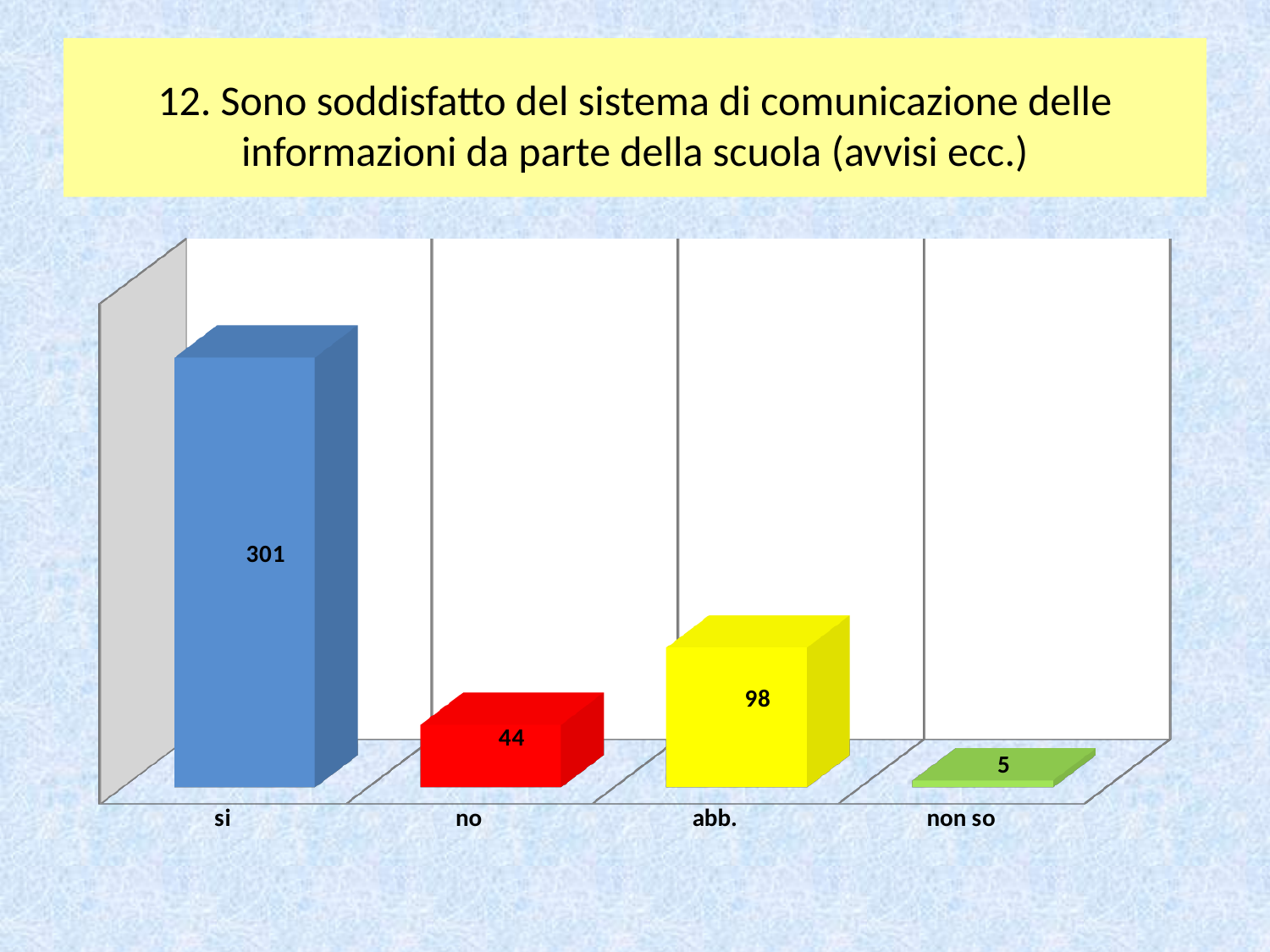
What is the difference between the values for "si" and "abb."? 203 How many categories are shown on the x axis? 4 What kind of chart is shown on the slide? bar chart What is the value for "si"? 301 What is the difference between the values for "abb." and "no"? 54 What is the value for "abb."? 98 What is the value for "no"? 44 Which category has the lowest value? non so Which category has the highest value? si Which is larger, the value for "no" or the value for "abb."? abb. What is the value for "non so"? 5 What colour is the bar for "abb."? yellow